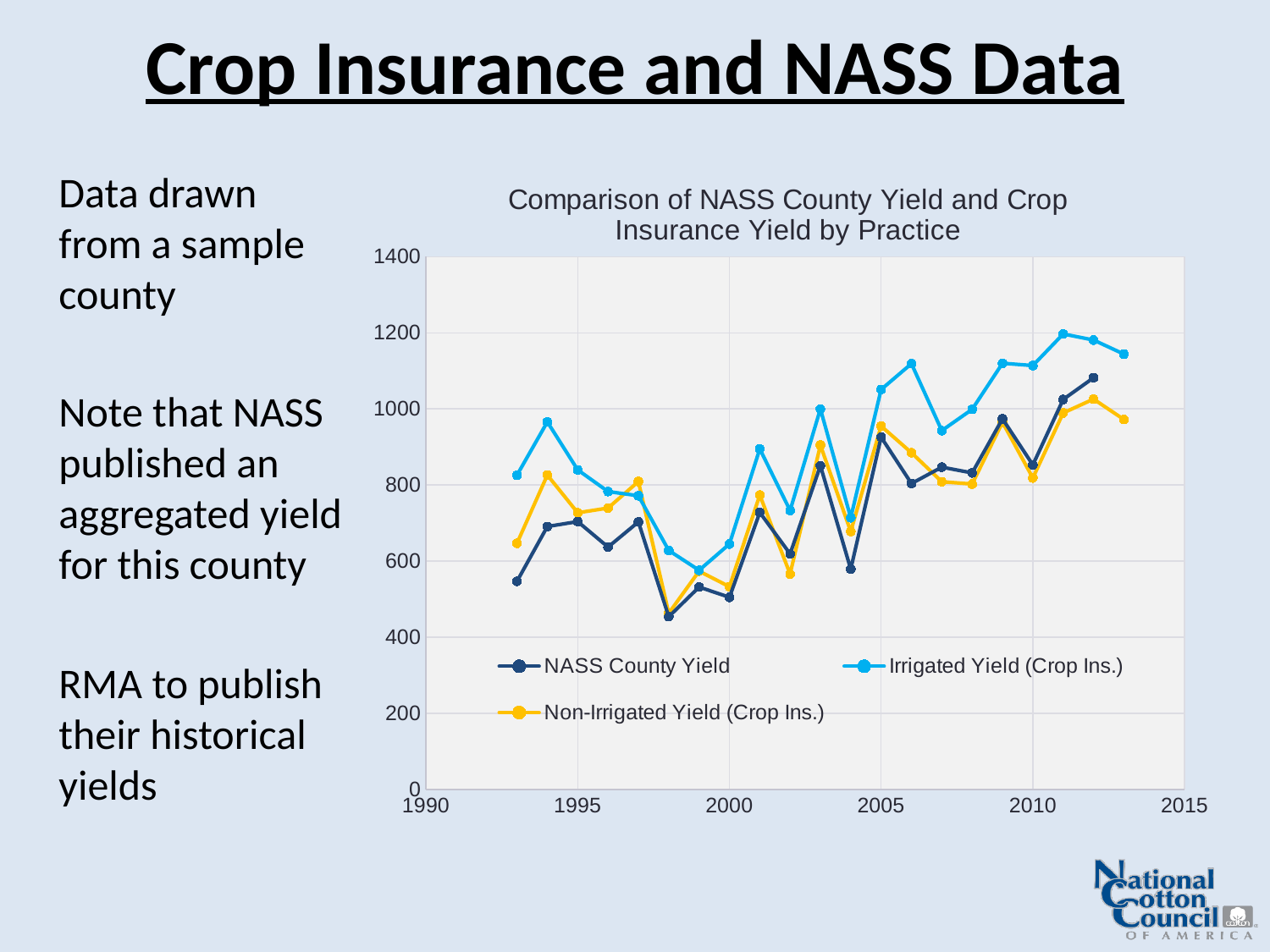
Is the Irrigated Yield (Crop Ins.) value for 2011 greater or less than 1000? greater Overall, does the Irrigated Yield (Crop Ins.) rise or fall from 1993 to 2013? rise Is the Irrigated Yield (Crop Ins.) value for 1999 greater or less than 800? less What kind of chart is shown on the slide? line chart In 2011, which is larger: the Irrigated Yield (Crop Ins.) or the NASS County Yield? Irrigated Yield (Crop Ins.) Is the NASS County Yield value for 2012 greater or less than 1000? greater Which series is drawn in yellow? Non-Irrigated Yield (Crop Ins.) What is the title of the chart? Comparison of NASS County Yield and Crop Insurance Yield by Practice In which year is the NASS County Yield at its lowest? 1998 How many series does the chart's legend list? 3